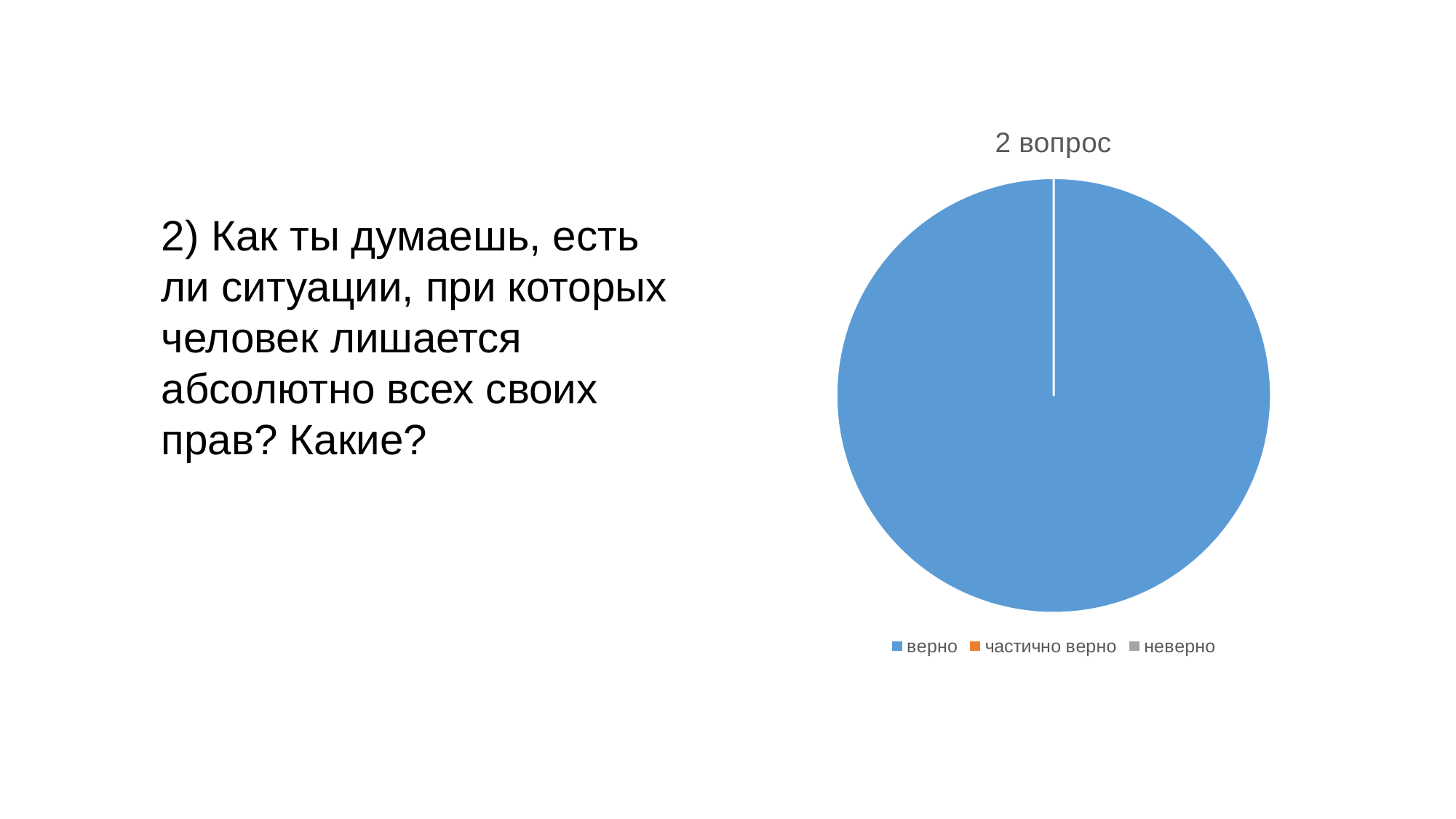
What is the title of the chart? 2 вопрос How many entries does the chart's legend list? 3 Which category has the largest slice of the pie? верно What colour represents the category верно in the chart? blue Which of the two categories, верно or частично верно, has the larger share of the pie? верно What kind of chart is shown on the slide? pie chart Which of the two categories, верно or неверно, has the larger share of the pie? верно